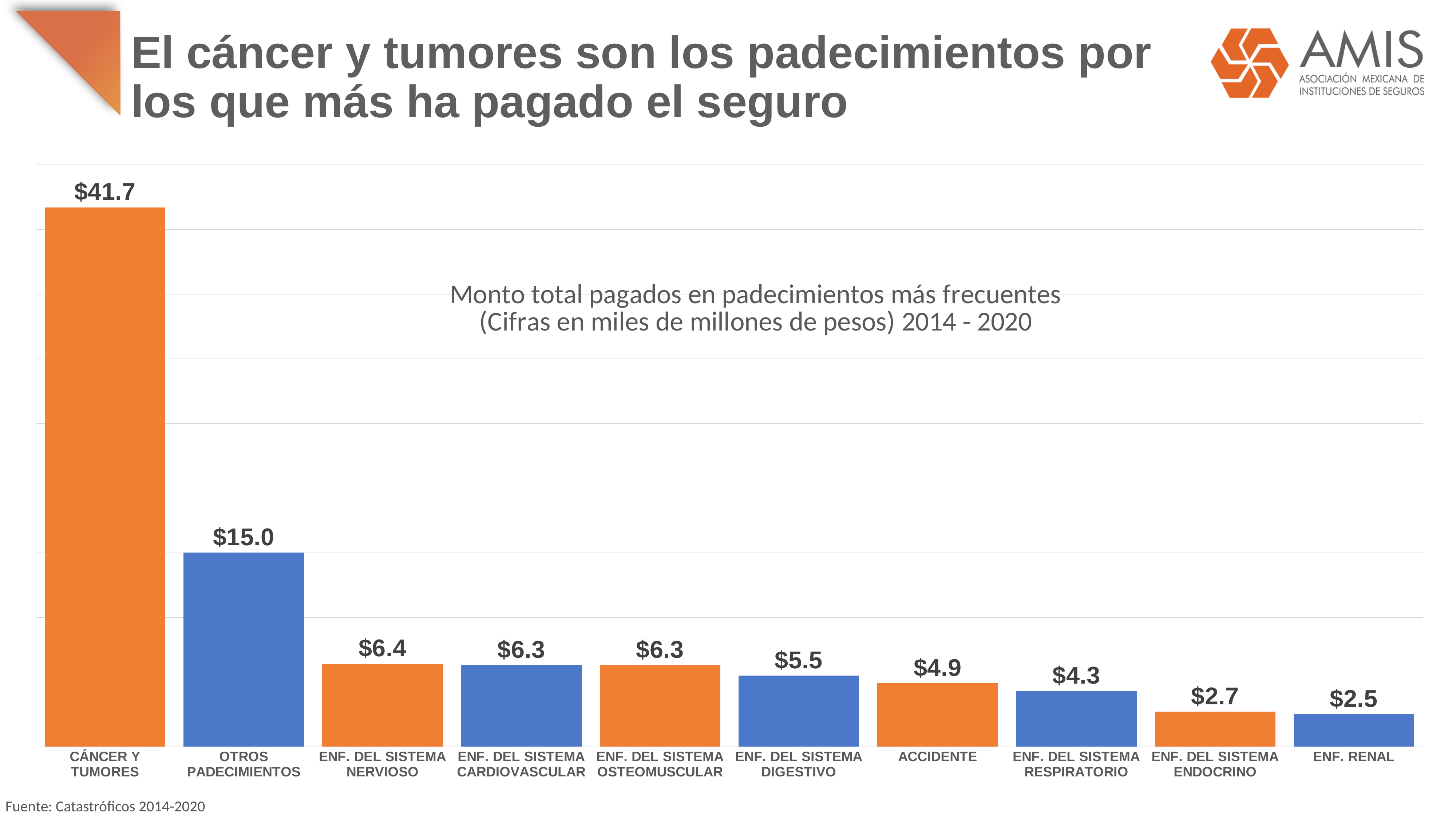
What is the value for CÁNCER Y TUMORES? $41.7 What is the title of the chart? Monto total pagados en padecimientos más frecuentes (Cifras en miles de millones de pesos) 2014 - 2020 What is the difference between the values for ACCIDENTE and ENF. DEL SISTEMA RESPIRATORIO? $0.6 What is the value for OTROS PADECIMIENTOS? $15.0 Which is larger, the value for ENF. DEL SISTEMA NERVIOSO or the value for ENF. DEL SISTEMA DIGESTIVO? ENF. DEL SISTEMA NERVIOSO How many categories are shown in the chart? 10 Which category has the lowest value? ENF. RENAL What kind of chart is shown on the slide? Bar chart What is the value for ENF. DEL SISTEMA DIGESTIVO? $5.5 Which category has the highest value? CÁNCER Y TUMORES What is the difference between the values for CÁNCER Y TUMORES and OTROS PADECIMIENTOS? $26.7 What is the value for ENF. RENAL? $2.5